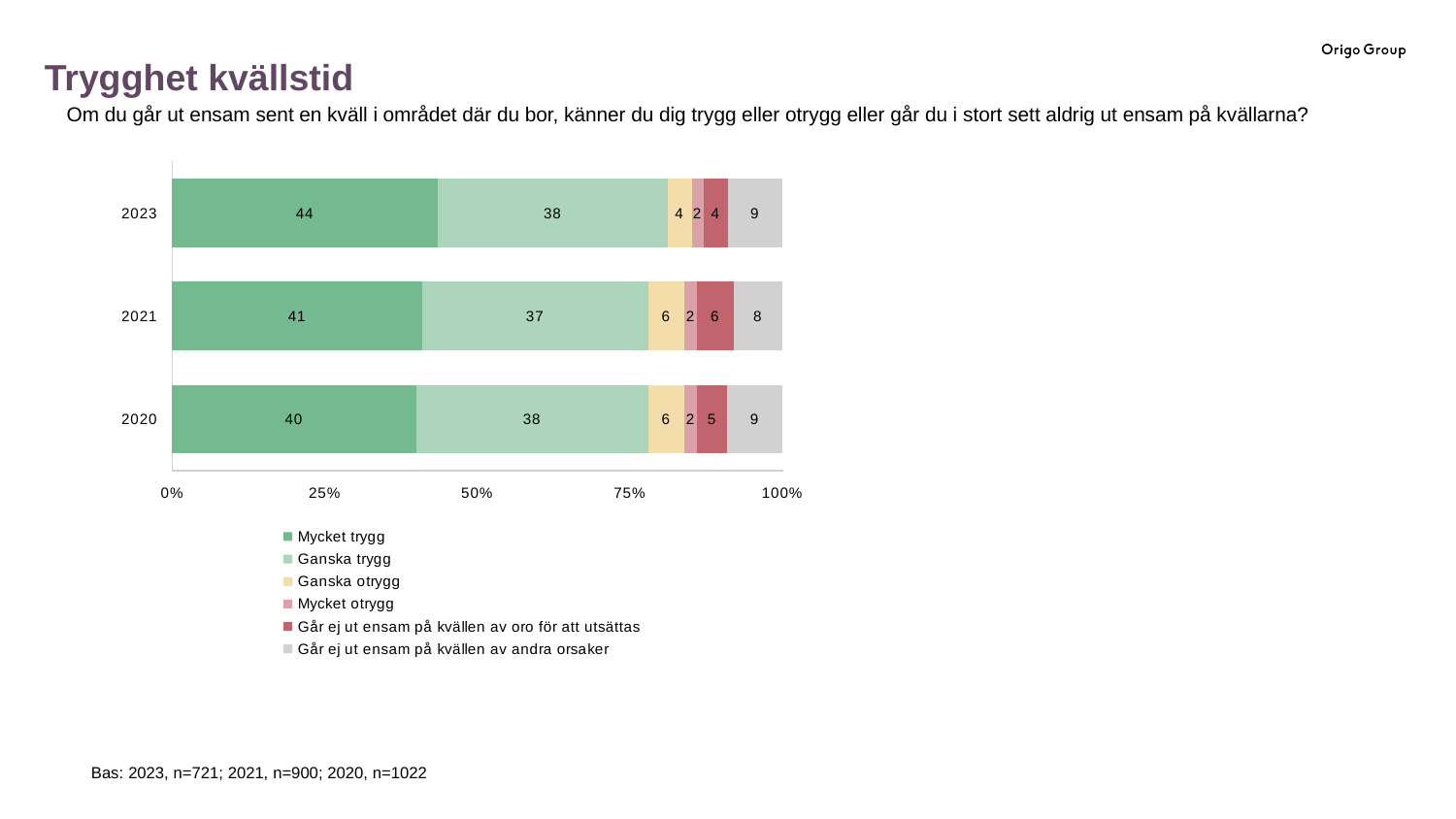
What kind of chart is shown on the slide? Stacked bar chart What is the value for "Går ej ut ensam på kvällen av andra orsaker" in 2020? 9 Which year has the lowest value for "Mycket trygg"? 2020 How many series does the legend list? 6 What is the title of the chart on the slide? Trygghet kvällstid Which year has the highest value for "Mycket trygg"? 2023 What is the difference between the "Mycket trygg" values for 2023 and 2020? 4 What is the value for "Ganska otrygg" in 2023? 4 Which is larger: the "Går ej ut ensam på kvällen av oro för att utsättas" value for 2021 or for 2023? 2021 What is the value for "Mycket trygg" in 2023? 44 How many years are shown on the chart? 3 What is the value for "Ganska trygg" in 2021? 37